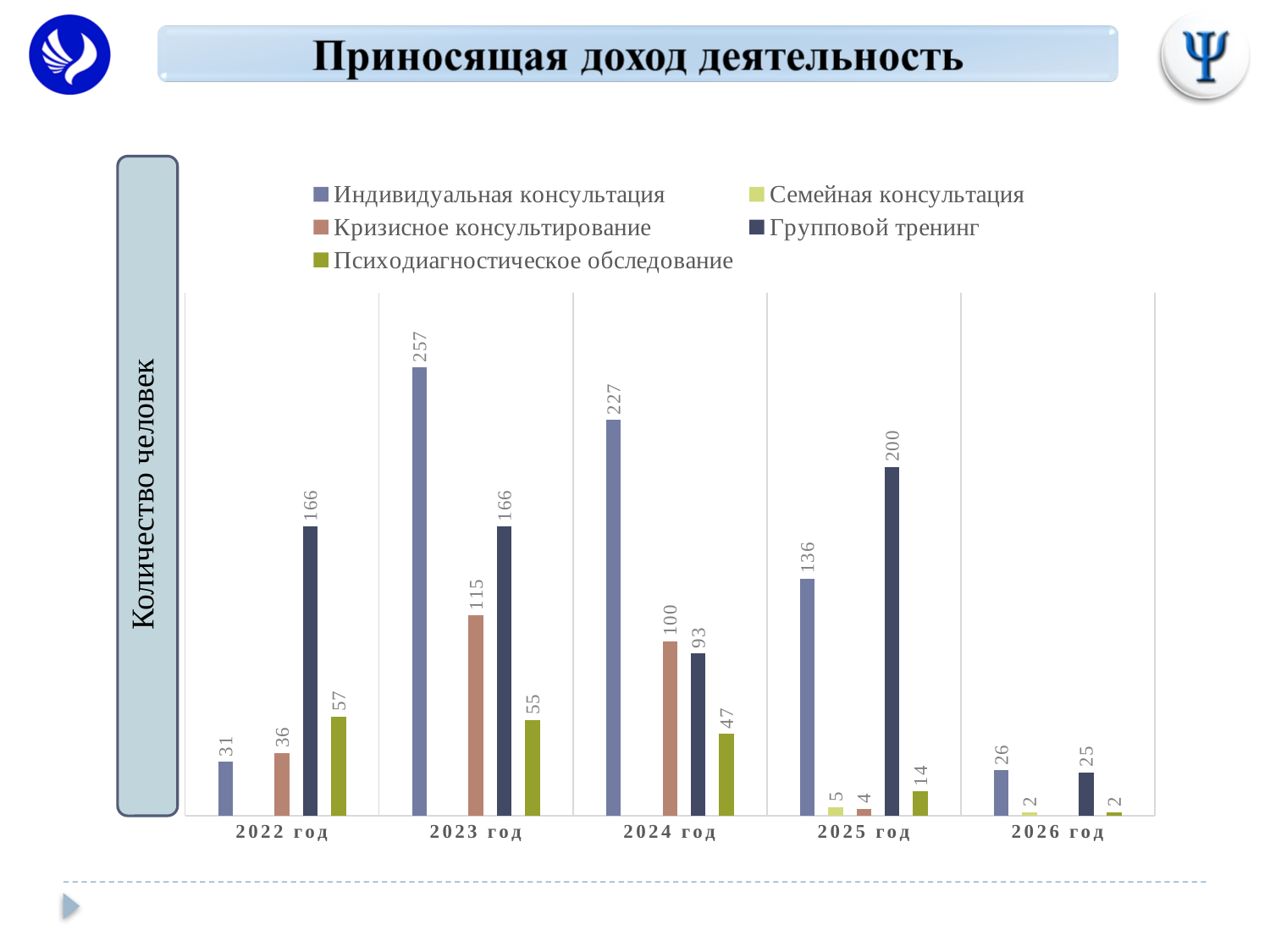
What is the value for Индивидуальная консультация in 2023 год? 257 Which is larger in 2024 год: Кризисное консультирование or Групповой тренинг? Кризисное консультирование What is the value for Групповой тренинг in 2025 год? 200 What is the label of the vertical axis? Количество человек What is the difference between Индивидуальная консультация in 2023 год and in 2024 год? 30 In which year is the value for Индивидуальная консультация highest? 2023 год In which year is the value for Психодиагностическое обследование lowest? 2026 год What is the value for Кризисное консультирование in 2024 год? 100 What type of chart is shown on the slide? bar chart How many series does the legend list? 5 How many year categories are shown on the x axis? 5 Does the value for Индивидуальная консультация rise or fall from 2023 год to 2026 год? fall